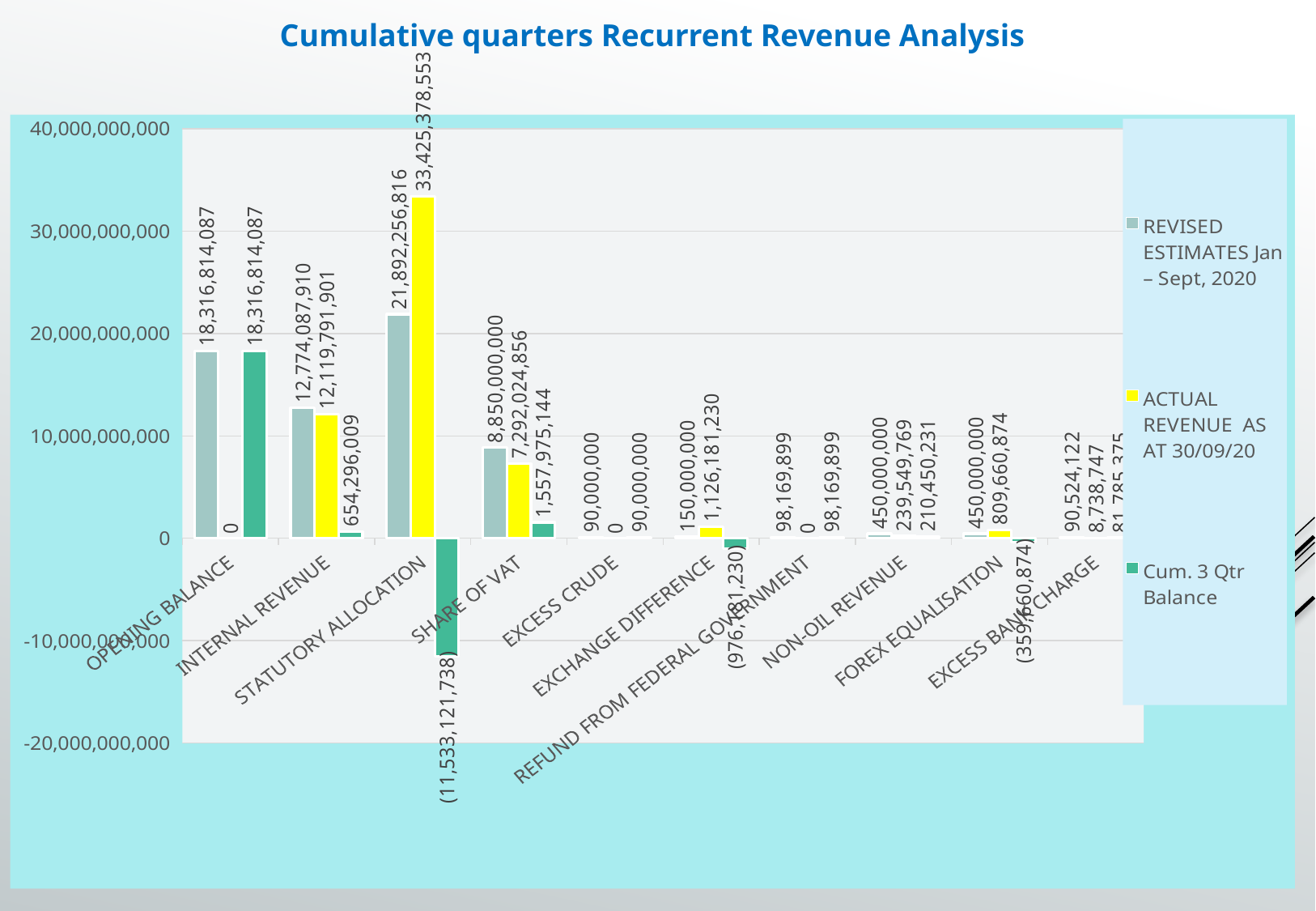
What is the difference between the REVISED ESTIMATES Jan – Sept, 2020 and ACTUAL REVENUE AS AT 30/09/20 values for INTERNAL REVENUE? 654,296,009 How many series does the legend list? 3 What is the ACTUAL REVENUE AS AT 30/09/20 value for EXCHANGE DIFFERENCE? 1,126,181,230 For FOREX EQUALISATION, which is larger: the REVISED ESTIMATES Jan – Sept, 2020 value or the ACTUAL REVENUE AS AT 30/09/20 value? ACTUAL REVENUE AS AT 30/09/20 What type of chart is shown on the slide? bar chart What is the title of the chart? Cumulative quarters Recurrent Revenue Analysis Which category has the highest ACTUAL REVENUE AS AT 30/09/20 value? STATUTORY ALLOCATION What is the REVISED ESTIMATES Jan – Sept, 2020 value for SHARE OF VAT? 8,850,000,000 What is the ACTUAL REVENUE AS AT 30/09/20 value for STATUTORY ALLOCATION? 33,425,378,553 How many categories are shown on the x axis? 10 What is the Cum. 3 Qtr Balance value for STATUTORY ALLOCATION? (11,533,121,738) Which category has the lowest Cum. 3 Qtr Balance value? STATUTORY ALLOCATION